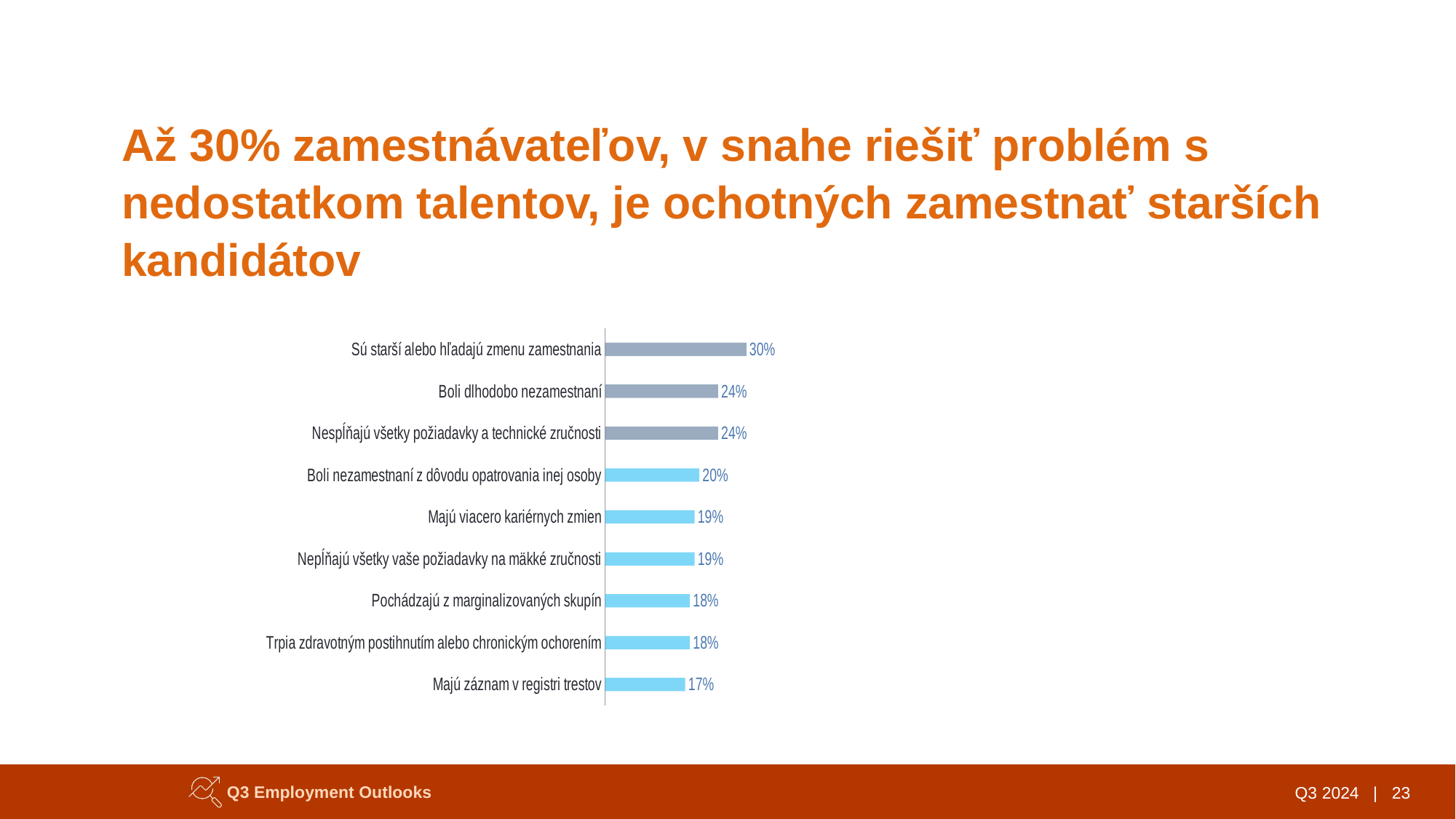
Which is larger: the value for "Nespĺňajú všetky požiadavky a technické zručnosti" or the value for "Majú viacero kariérnych zmien"? Nespĺňajú všetky požiadavky a technické zručnosti Which category has the lowest value? Majú záznam v registri trestov Which category has the highest value? Sú starší alebo hľadajú zmenu zamestnania What is the difference between the values for "Sú starší alebo hľadajú zmenu zamestnania" and "Boli dlhodobo nezamestnaní"? 6% What is the difference between the values for "Boli nezamestnaní z dôvodu opatrovania inej osoby" and "Majú záznam v registri trestov"? 3% What is the value for "Sú starší alebo hľadajú zmenu zamestnania"? 30% What kind of chart is shown on the slide? Bar chart What is the value for "Boli nezamestnaní z dôvodu opatrovania inej osoby"? 20% What is the value for "Pochádzajú z marginalizovaných skupín"? 18% How many categories are shown in the chart? 9 How many bars are coloured grey rather than light blue? 3 What is the value for "Majú záznam v registri trestov"? 17%